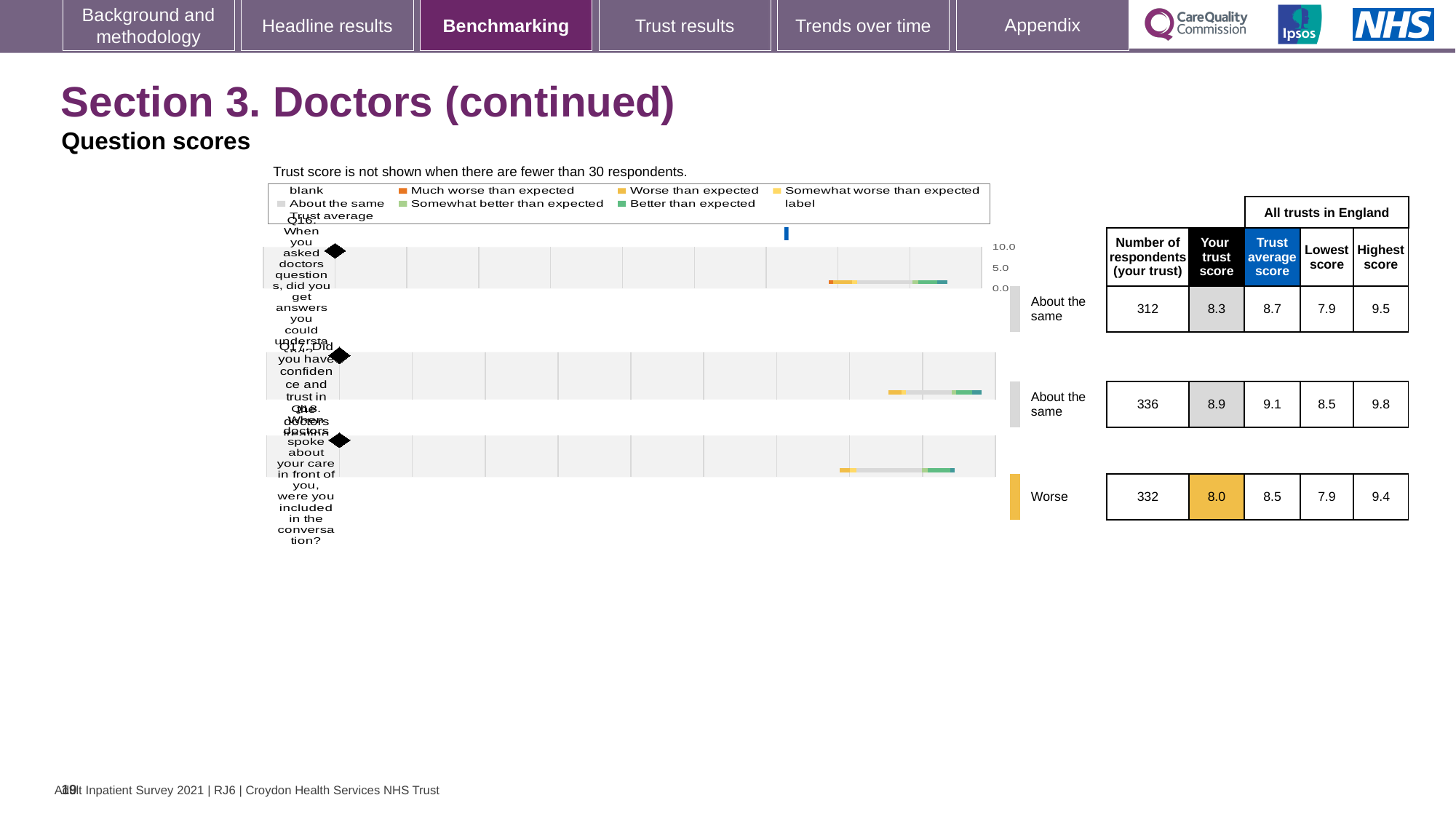
What is the highest score across all trusts in England for Q18? 9.4 Which question is rated 'Worse' in the benchmarking category column? Q18 Which question has the lowest 'Your trust score'? Q18 What is the 'Your trust score' for Q17 (confidence and trust in the doctors)? 8.9 How many respondents answered Q16 at the trust? 312 Is 'Your trust score' for Q16 larger or smaller than the trust average score for Q16? smaller What is the difference between the trust average score and 'Your trust score' for Q18? 0.5 What is the lowest score across all trusts in England for Q17? 8.5 Which question has the highest 'Your trust score'? Q17 What is the trust average score for Q16? 8.7 What kind of chart is shown on the slide? bar chart How many questions are plotted in the chart? 3